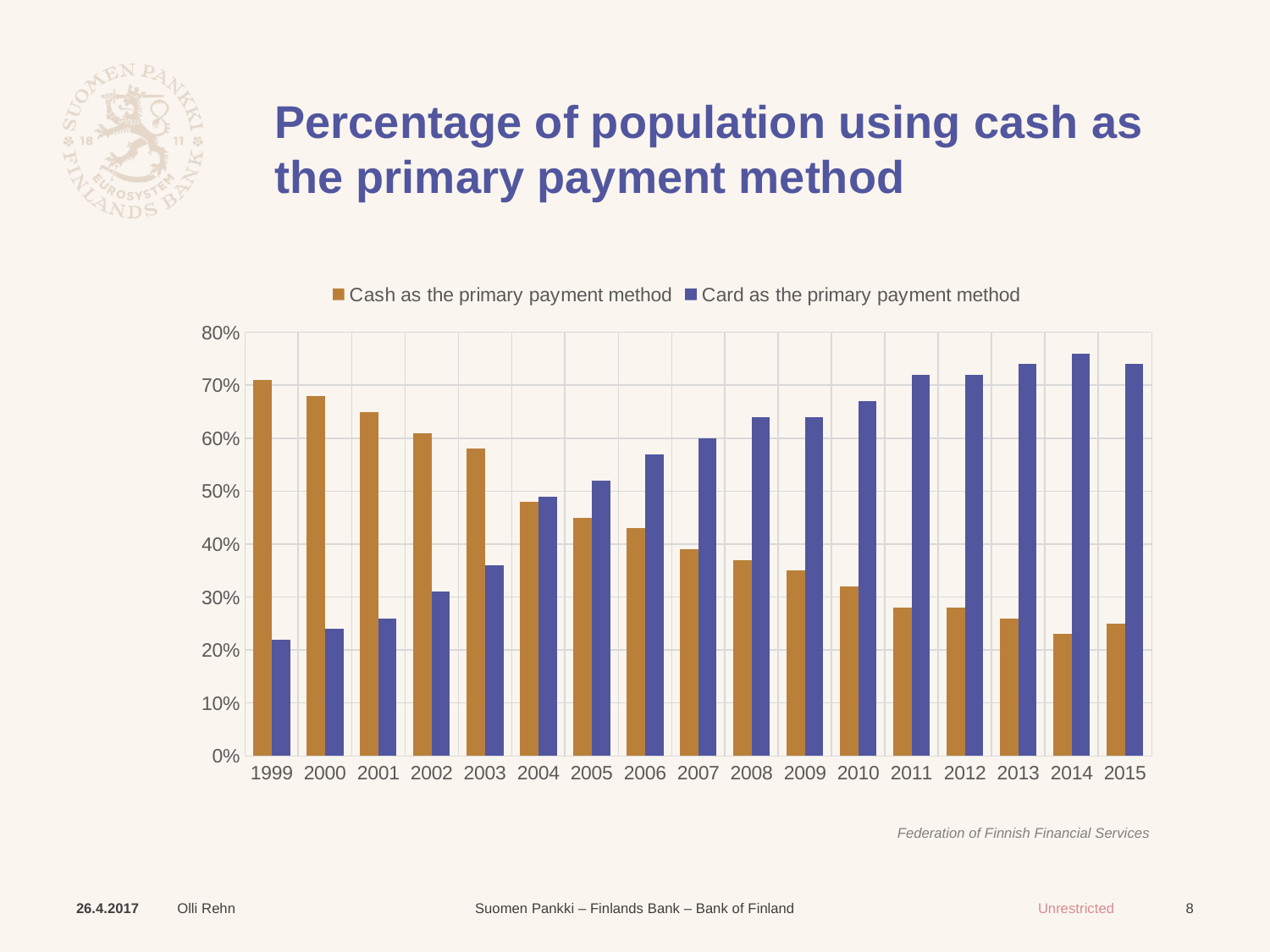
Is the value for 'Card as the primary payment method' in 1999 greater or less than 30%? less How many series does the legend list? 2 In 2003, which is larger: cash as the primary payment method or card as the primary payment method? Cash as the primary payment method In which year is the value for 'Card as the primary payment method' lowest? 1999 What kind of chart is shown on the slide? Bar chart In which year is the value for 'Cash as the primary payment method' highest? 1999 Is the value for 'Cash as the primary payment method' in 2015 greater or less than 30%? less Is the value for 'Card as the primary payment method' in 2015 greater or less than 70%? greater What is the source cited below the chart? Federation of Finnish Financial Services Does the value for 'Cash as the primary payment method' generally rise or fall from 1999 to 2015? Fall How many years are shown on the x axis? 17